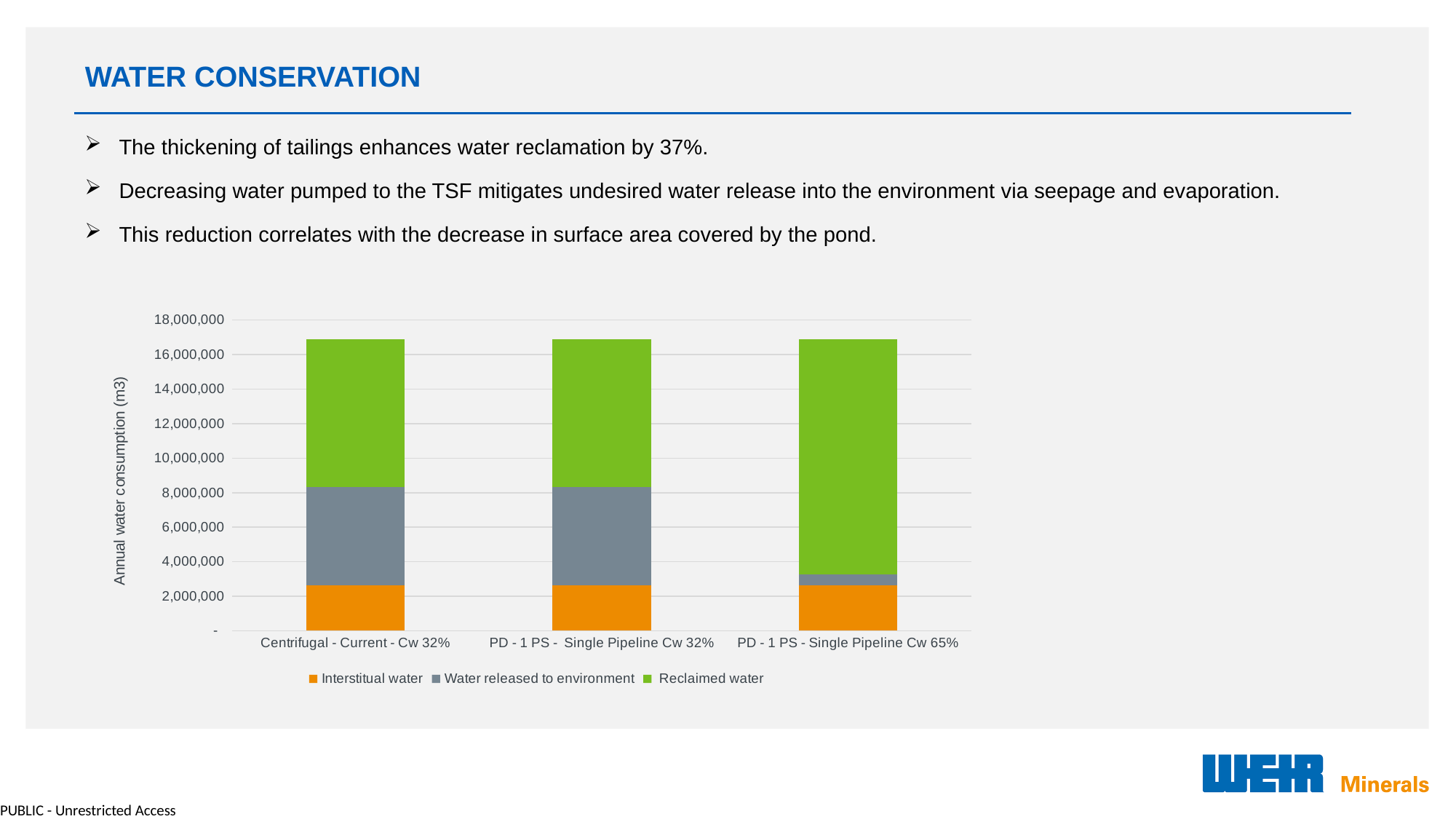
How many series does the chart legend list? 3 Is the total height of the Centrifugal - Current - Cw 32% bar greater or less than 18,000,000? less Which series is shown in green in the chart? Reclaimed water How many categories are shown on the x axis of the chart? 3 What is the label of the y axis of the chart? Annual water consumption (m3) What kind of chart is shown on the slide? Stacked bar chart Is the total height of the PD - 1 PS - Single Pipeline Cw 65% bar greater or less than 16,000,000? greater Is the Water released to environment segment larger for PD - 1 PS - Single Pipeline Cw 32% or for PD - 1 PS - Single Pipeline Cw 65%? PD - 1 PS - Single Pipeline Cw 32% Which category has the smallest Water released to environment segment? PD - 1 PS - Single Pipeline Cw 65% Is the Reclaimed water segment larger for Centrifugal - Current - Cw 32% or for PD - 1 PS - Single Pipeline Cw 65%? PD - 1 PS - Single Pipeline Cw 65% Is the Water released to environment segment for Centrifugal - Current - Cw 32% greater or less than 4,000,000? greater Which category has the largest Reclaimed water segment? PD - 1 PS - Single Pipeline Cw 65%